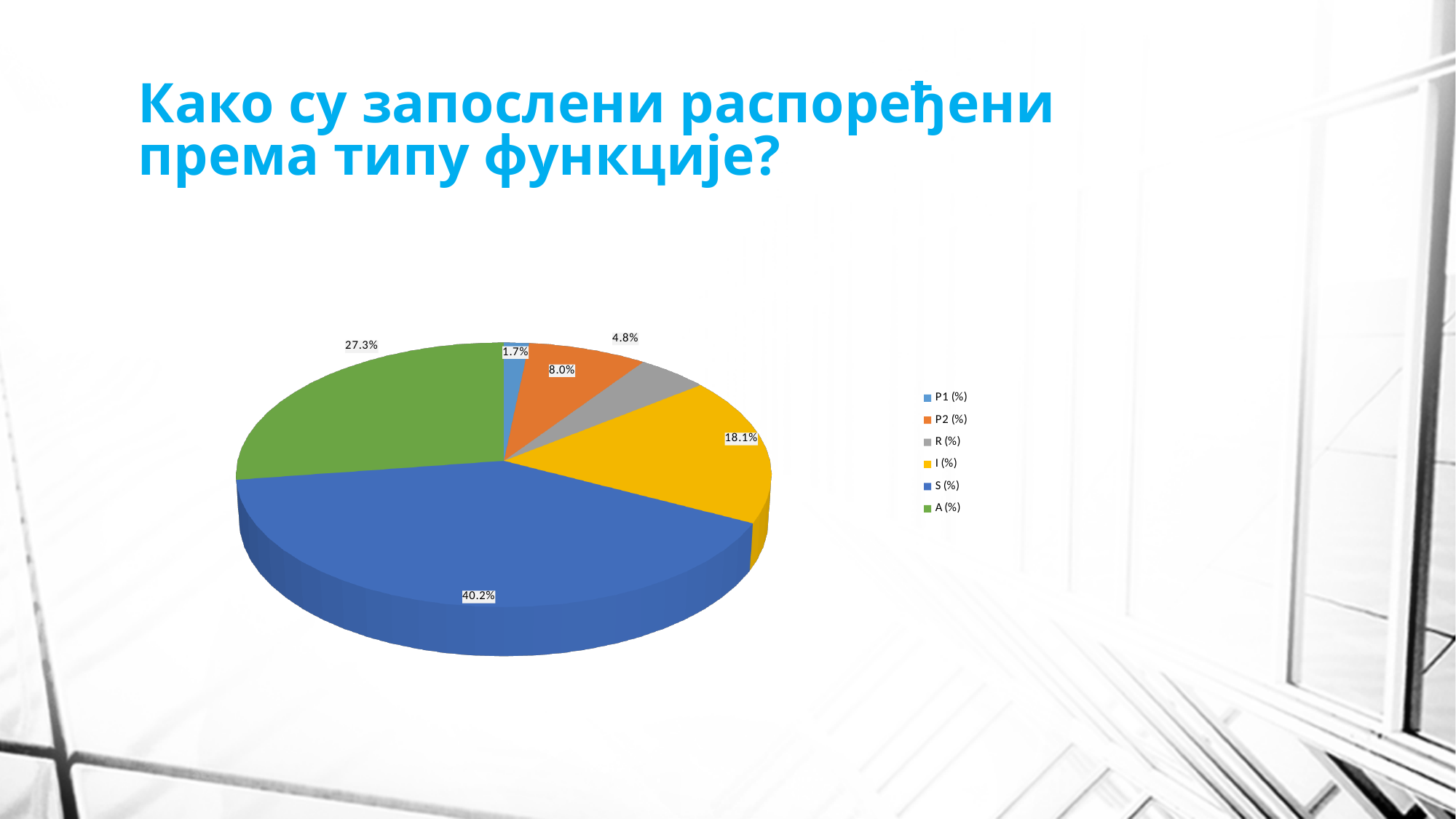
What is the value for R (%) in the pie chart? 4.8% How many categories does the legend of the pie chart list? 6 What is the value for P1 (%) in the pie chart? 1.7% What kind of chart is shown on the slide? pie chart What is the value for A (%) in the pie chart? 27.3% Which category has the smallest slice in the pie chart? P1 (%) Which category has the largest slice in the pie chart? S (%) Which is larger in the pie chart, P2 (%) or R (%)? P2 (%) What is the difference between the values for S (%) and A (%) in the pie chart? 12.9% What is the value for I (%) in the pie chart? 18.1% What is the value for S (%) in the pie chart? 40.2% What is the value for P2 (%) in the pie chart? 8.0%